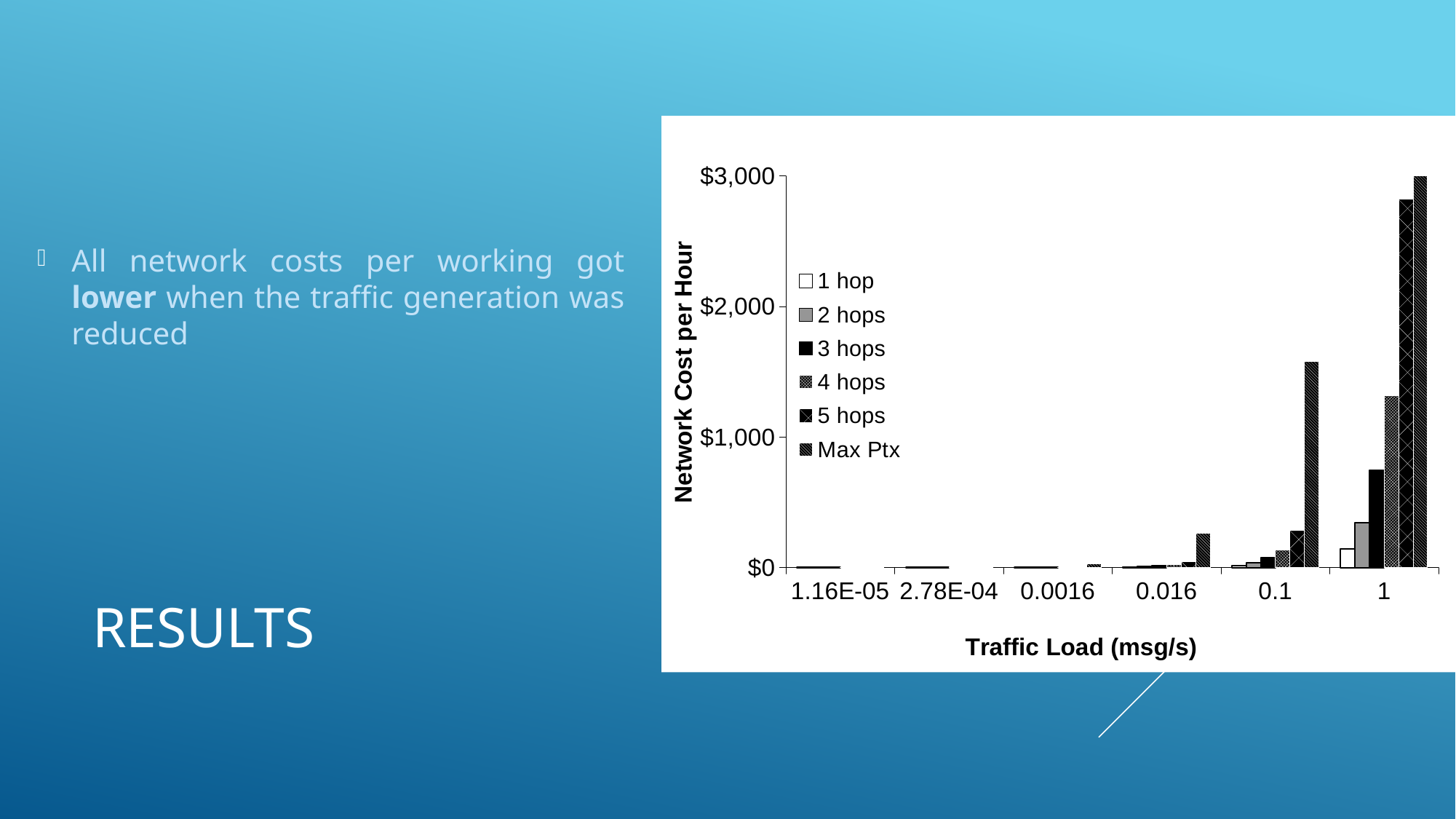
Which series has the highest bar at a traffic load of 1 msg/s? Max Ptx What is the title of the y axis? Network Cost per Hour Is the value for 3 hops at a traffic load of 1 greater or less than $1,000? less Is the value for 4 hops at a traffic load of 1 greater or less than $1,000? greater Is the value for Max Ptx at a traffic load of 1 greater or less than $2,000? greater How many traffic load categories are shown on the x axis? 6 Which is larger: the Max Ptx value at a traffic load of 1 or at a traffic load of 0.1? traffic load of 1 How many series does the legend list? 6 What kind of chart is shown on the slide? bar chart Do the network costs rise or fall as the traffic load increases along the x axis? rise